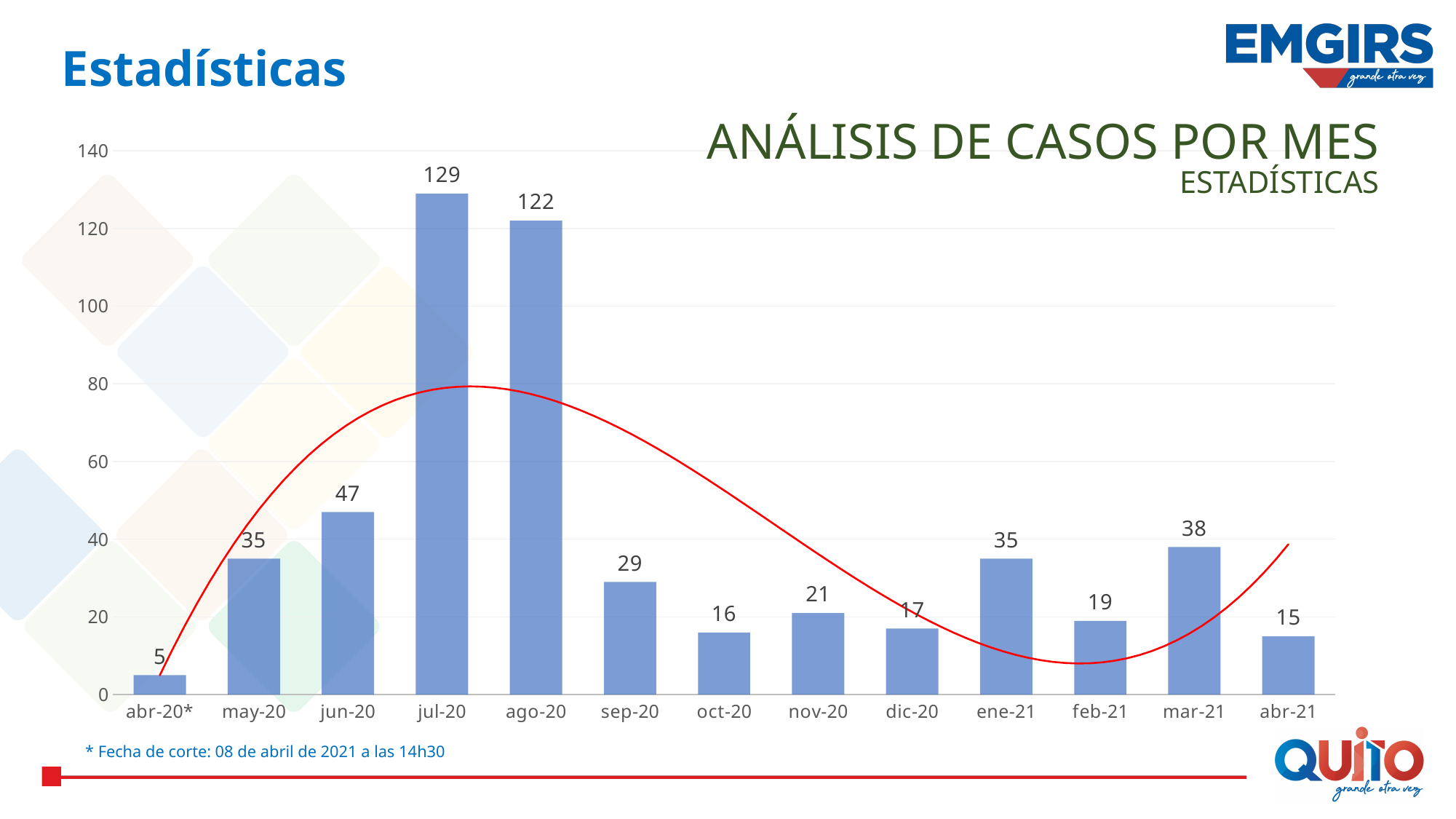
What is the title of the chart? ANÁLISIS DE CASOS POR MES Which is larger, the value for mar-21 or the value for feb-21? mar-21 What is the value for ene-21? 35 Is the value for jun-20 greater or less than 40? greater What is the value for jul-20? 129 What is the difference between the values for jul-20 and ago-20? 7 Which month has the lowest value? abr-20* What kind of chart is this? bar chart Do the values rise or fall from sep-20 to oct-20? fall Which month has the highest value? jul-20 How many months are shown on the x axis? 13 What is the value for abr-21? 15